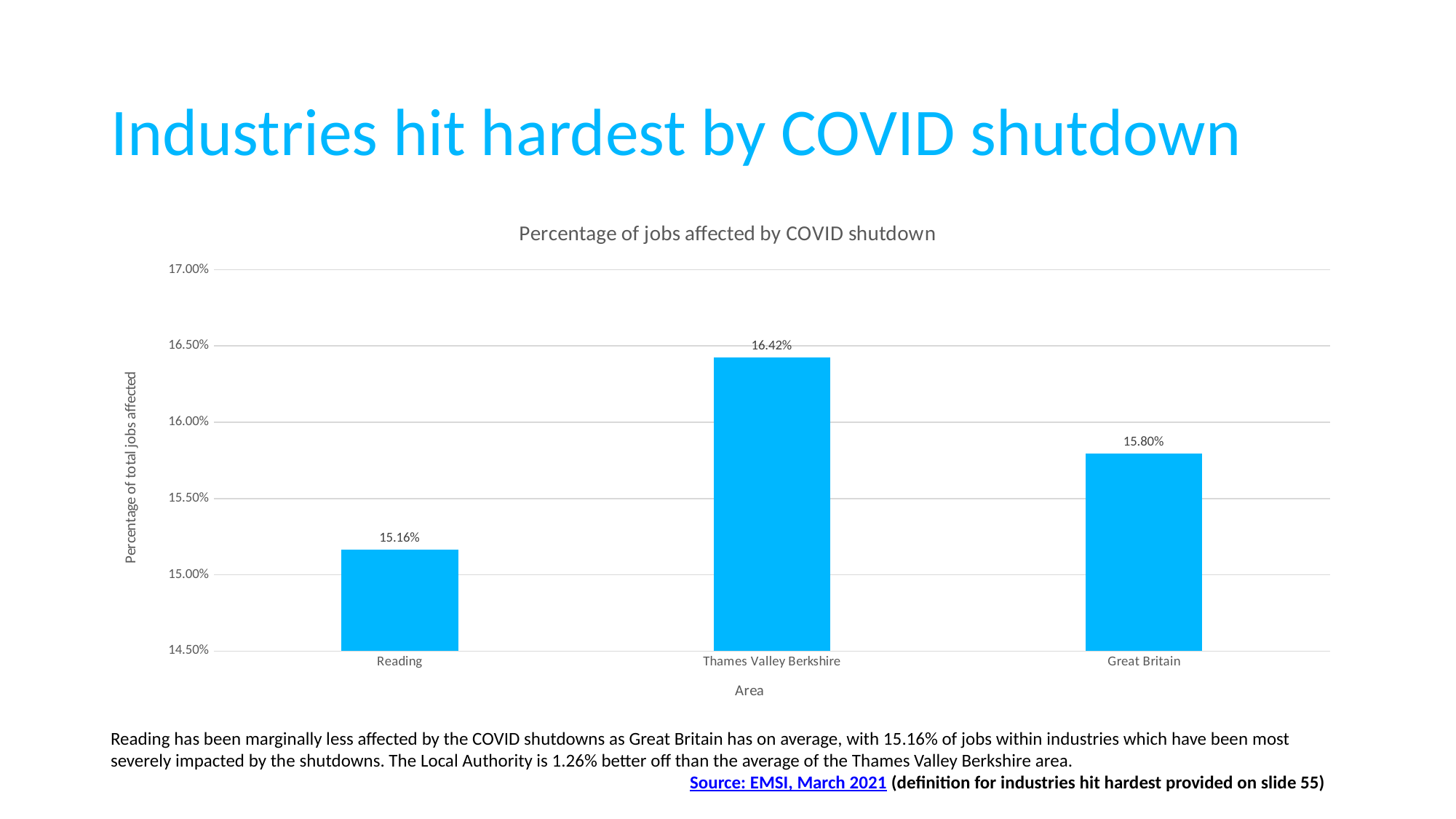
How many areas are shown in the chart? 3 What is the difference in percentage points between Great Britain and Reading? 0.64% Which area has the lowest percentage of jobs affected by COVID shutdown? Reading What is the difference in percentage points between Thames Valley Berkshire and Reading? 1.26% What type of chart is shown on the slide? Bar chart Which area has the highest percentage of jobs affected by COVID shutdown? Thames Valley Berkshire Which has a higher percentage of jobs affected, Great Britain or Reading? Great Britain What is the percentage of jobs affected by COVID shutdown for Great Britain? 15.80% What is the title of the chart? Percentage of jobs affected by COVID shutdown What is the percentage of jobs affected by COVID shutdown for Thames Valley Berkshire? 16.42% Is the value for Thames Valley Berkshire greater or less than 16.00%? greater What is the percentage of jobs affected by COVID shutdown for Reading? 15.16%